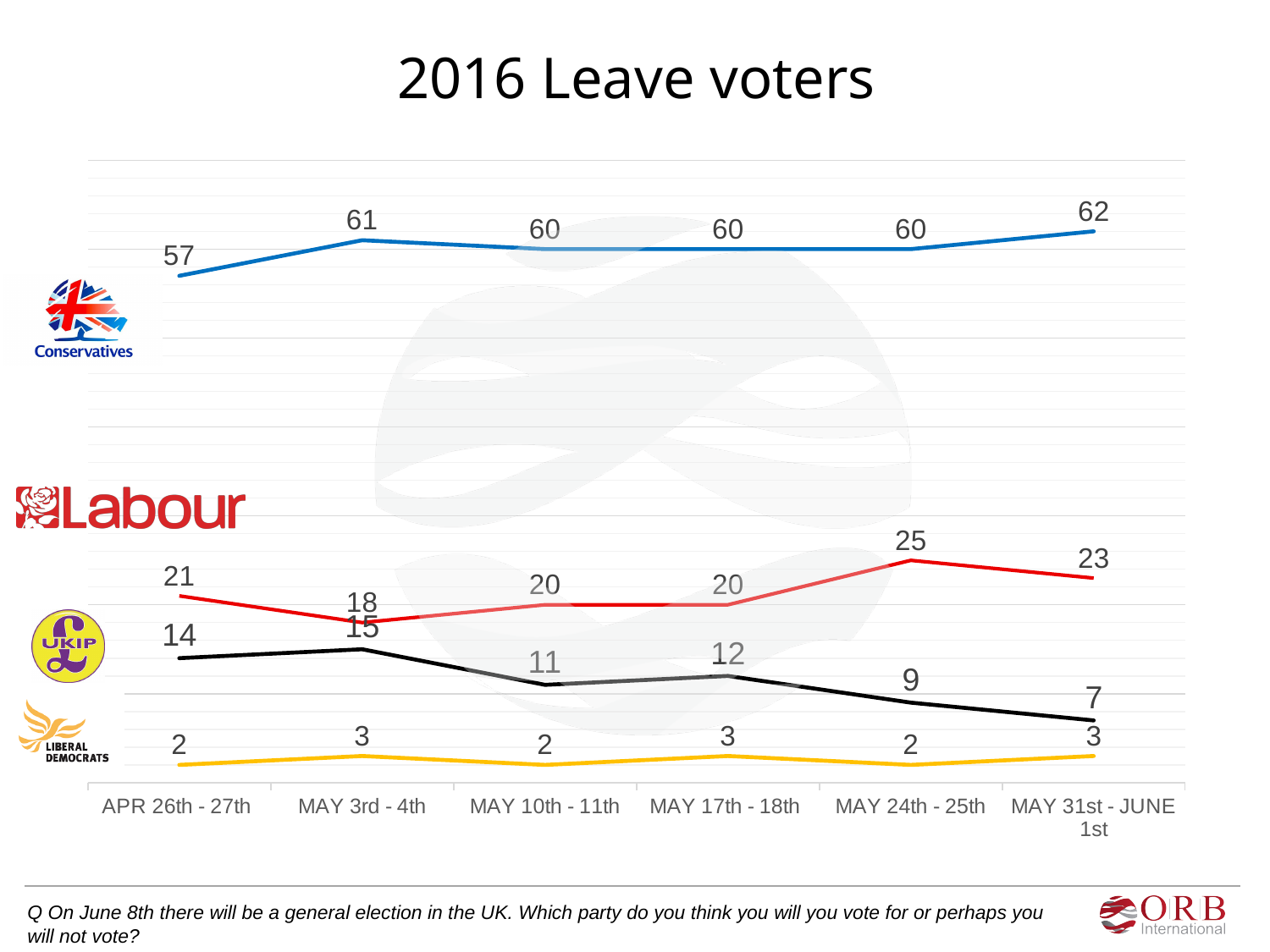
How many party lines are plotted on the chart? 4 How many dates are shown along the x axis? 6 What is the value for Conservatives at APR 26th - 27th? 57 What is the value for Liberal Democrats at MAY 3rd - 4th? 3 What kind of chart is shown on the slide? line chart Which is larger at MAY 3rd - 4th: the Labour value or the UKIP value? Labour At which date does the Conservatives line reach its highest value? MAY 31st - JUNE 1st What is the value for Labour at MAY 24th - 25th? 25 Does the UKIP line generally rise or fall from APR 26th - 27th to MAY 31st - JUNE 1st? fall What is the value for UKIP at MAY 31st - JUNE 1st? 7 At which date does the UKIP line reach its lowest value? MAY 31st - JUNE 1st What is the difference between the Labour value and the UKIP value at MAY 24th - 25th? 16